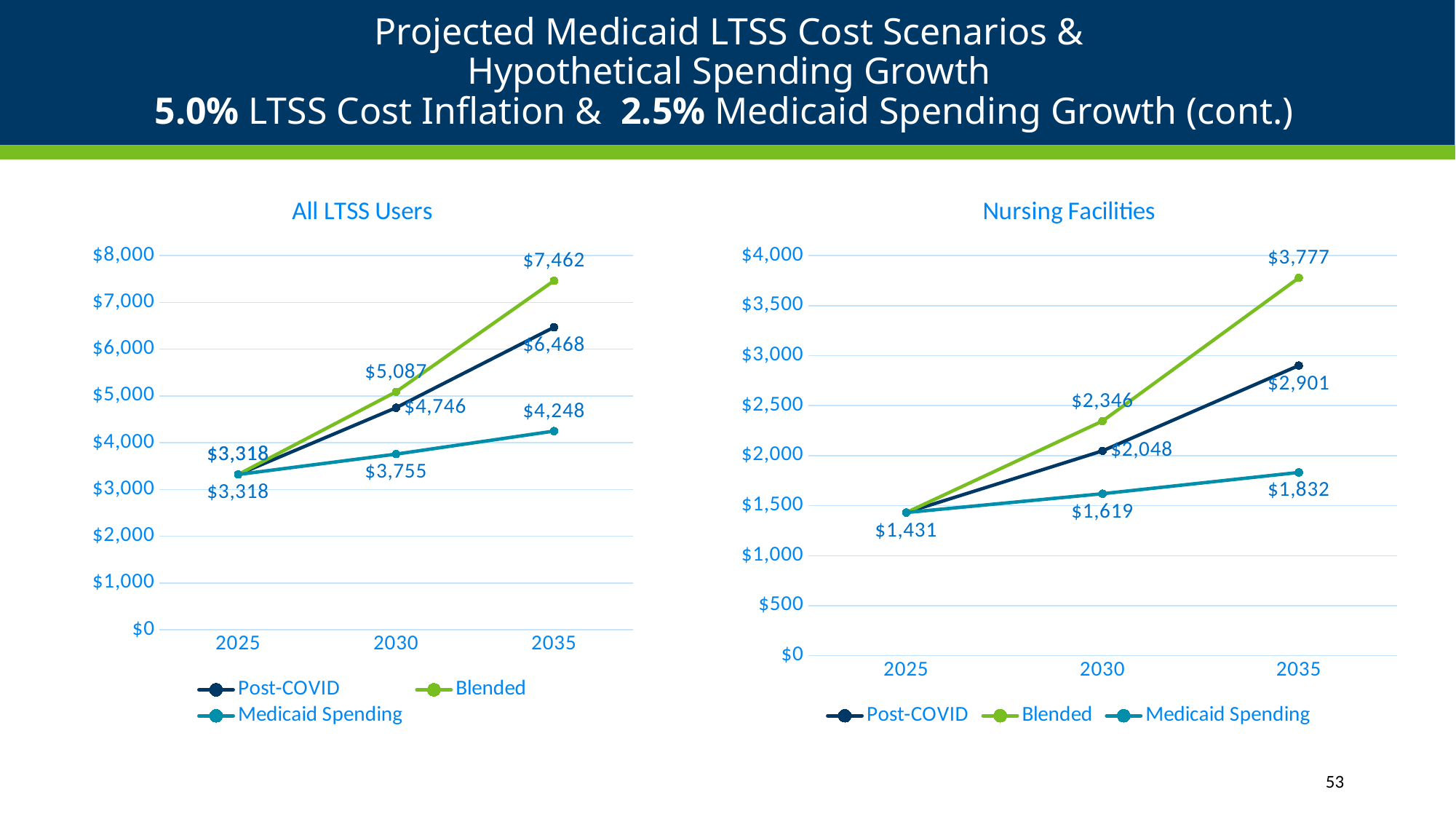
In the All LTSS Users chart, does the Post-COVID series rise or fall from 2025 to 2035? Rise In the Nursing Facilities chart, what is the Post-COVID value for 2035? $2,901 In the Nursing Facilities chart, which is larger in 2030: Post-COVID or Medicaid Spending? Post-COVID How many series does the legend of the All LTSS Users chart list? 3 In the All LTSS Users chart, what is the difference between the Blended and Post-COVID values in 2035? $994 In the Nursing Facilities chart, what is the Blended value for 2030? $2,346 In the Nursing Facilities chart, what is the difference between the Blended and Medicaid Spending values in 2035? $1,945 In the All LTSS Users chart, what is the Blended value for 2035? $7,462 In the Nursing Facilities chart, which series has the lowest value in 2035? Medicaid Spending What kind of chart is the Nursing Facilities chart? Line chart In the All LTSS Users chart, what is the Medicaid Spending value for 2030? $3,755 In the All LTSS Users chart, which series has the highest value in 2035? Blended